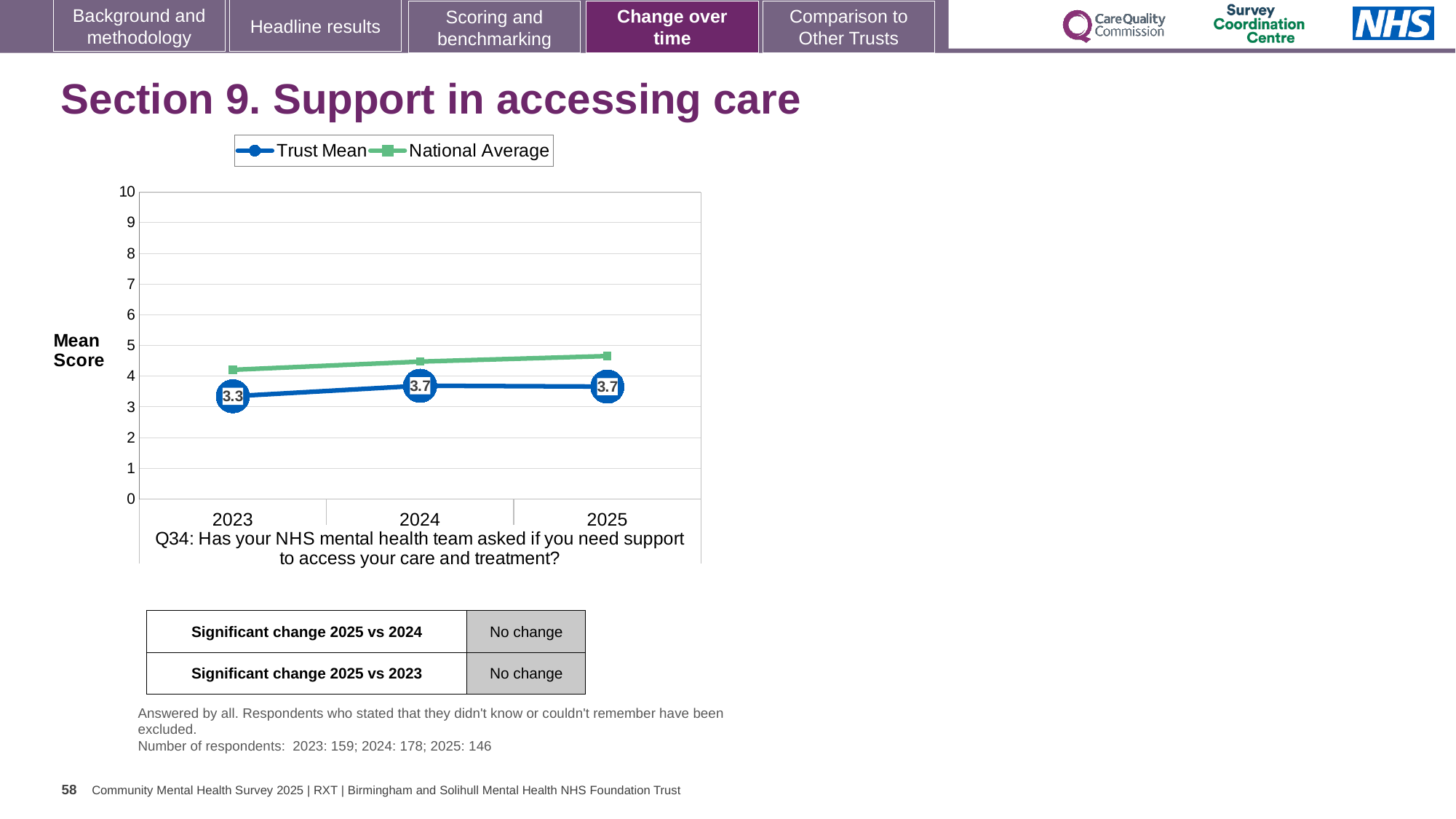
How many series does the legend list? 2 Is the National Average value for 2023 greater or less than 5? less Does the National Average rise or fall from 2023 to 2025? Rise In which year is the Trust Mean score lowest? 2023 What kind of chart is shown on the slide? Line chart Which is higher in 2025, the Trust Mean or the National Average? National Average What is the Trust Mean score for 2025? 3.7 What is the Trust Mean score for 2024? 3.7 How many years are plotted on the x axis? 3 What is the Trust Mean score for 2023? 3.3 What is the difference between the Trust Mean score in 2024 and in 2023? 0.4 Is the National Average value for 2025 greater or less than 4? greater